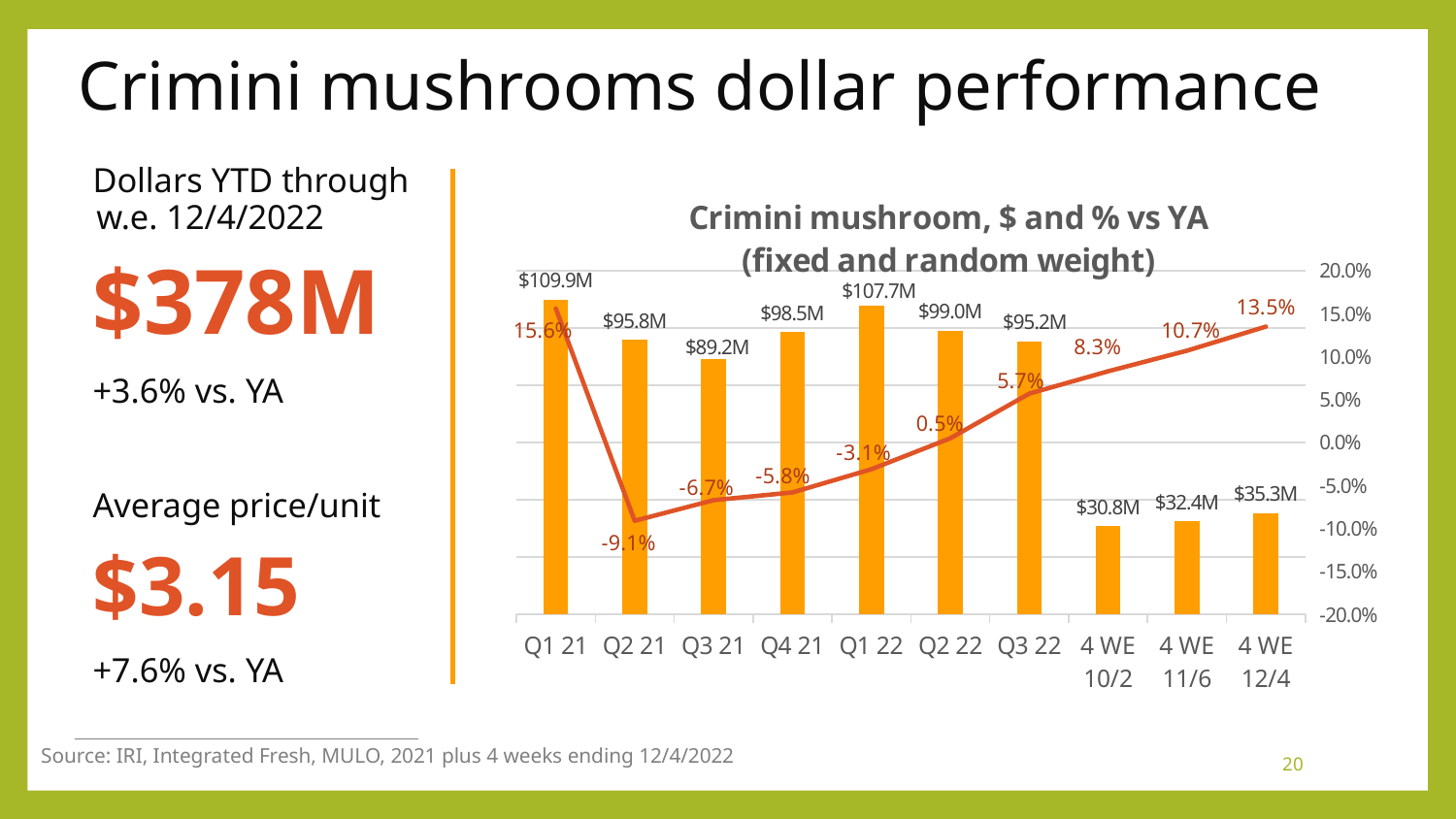
Does the % vs YA line rise or fall from Q2 21 to 4 WE 12/4? Rise Which category has the highest dollar value? Q1 21 How many categories are shown on the x axis? 10 What is the % vs YA value for Q2 21? -9.1% What is the % vs YA value for 4 WE 11/6? 10.7% What kind of chart is this? Combination bar and line chart What is the dollar value for Q1 22? $107.7M What is the dollar value for the 4 WE 12/4 period? $35.3M Which is larger, the dollar value for Q4 21 or Q2 22? Q2 22 What is the title of the chart? Crimini mushroom, $ and % vs YA (fixed and random weight) What is the difference in dollar value between Q1 21 and Q3 21? $20.7M Which category has the lowest % vs YA value? Q2 21